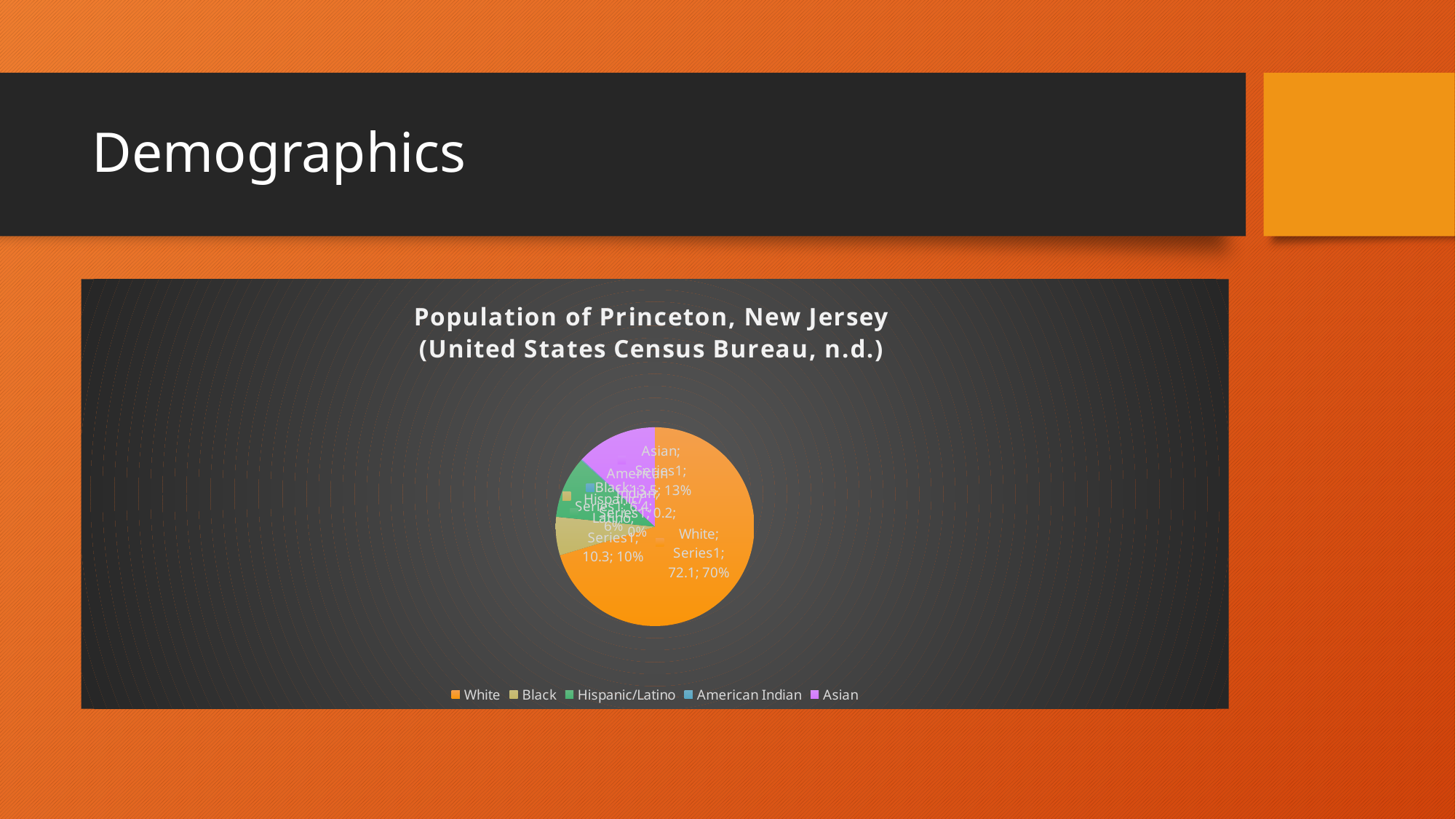
Which slice is larger, Asian or Black? Asian Which category has the largest slice of the pie chart? White Which category has the smallest slice of the pie chart? American Indian What is the title of the chart? Population of Princeton, New Jersey (United States Census Bureau, n.d.) What percentage share of the pie is labelled for the Asian slice? 13% What value is labelled for the White slice? 72.1 How many categories does the legend of the pie chart list? 5 What value is labelled for the Asian slice? 13.5 What percentage share of the pie is labelled for the White slice? 70% What is the difference between the labelled values for White and Black? 65.7 What value is labelled for the Black slice? 6.4 What kind of chart is shown on the slide? pie chart